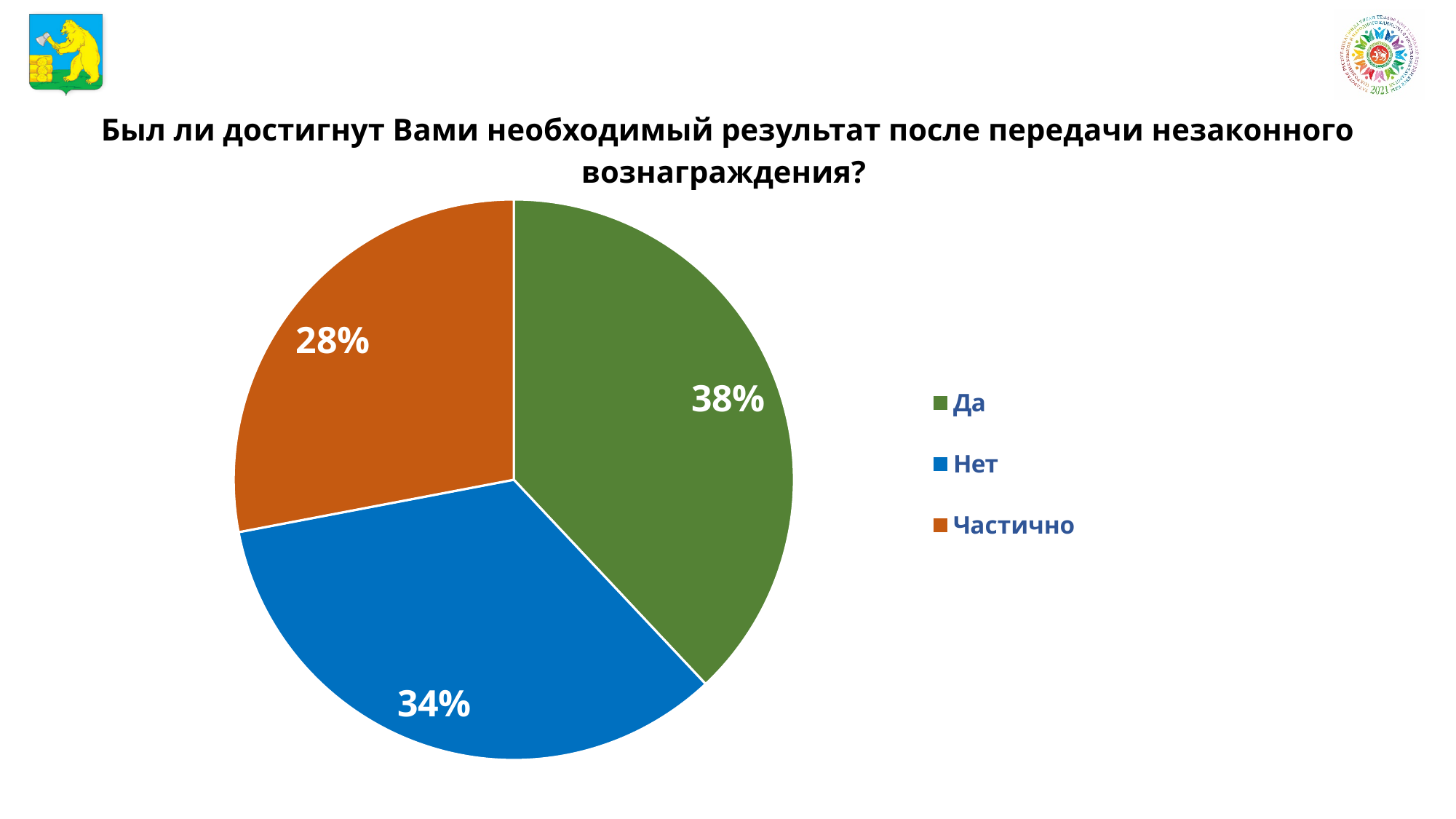
What share of the pie does "Да" represent? 38% Which is larger, the share for "Да" or the share for "Нет"? Да What is the title of the chart? Был ли достигнут Вами необходимый результат после передачи незаконного вознаграждения? What share of the pie does "Частично" represent? 28% How many categories does the pie chart have? 3 Which category has the largest slice of the pie? Да What share of the pie does "Нет" represent? 34% What is the difference between the shares for "Нет" and "Частично"? 6% What type of chart is shown on the slide? pie chart What is the difference between the shares for "Да" and "Частично"? 10% What colour is the slice for "Нет"? blue Which category has the smallest slice of the pie? Частично